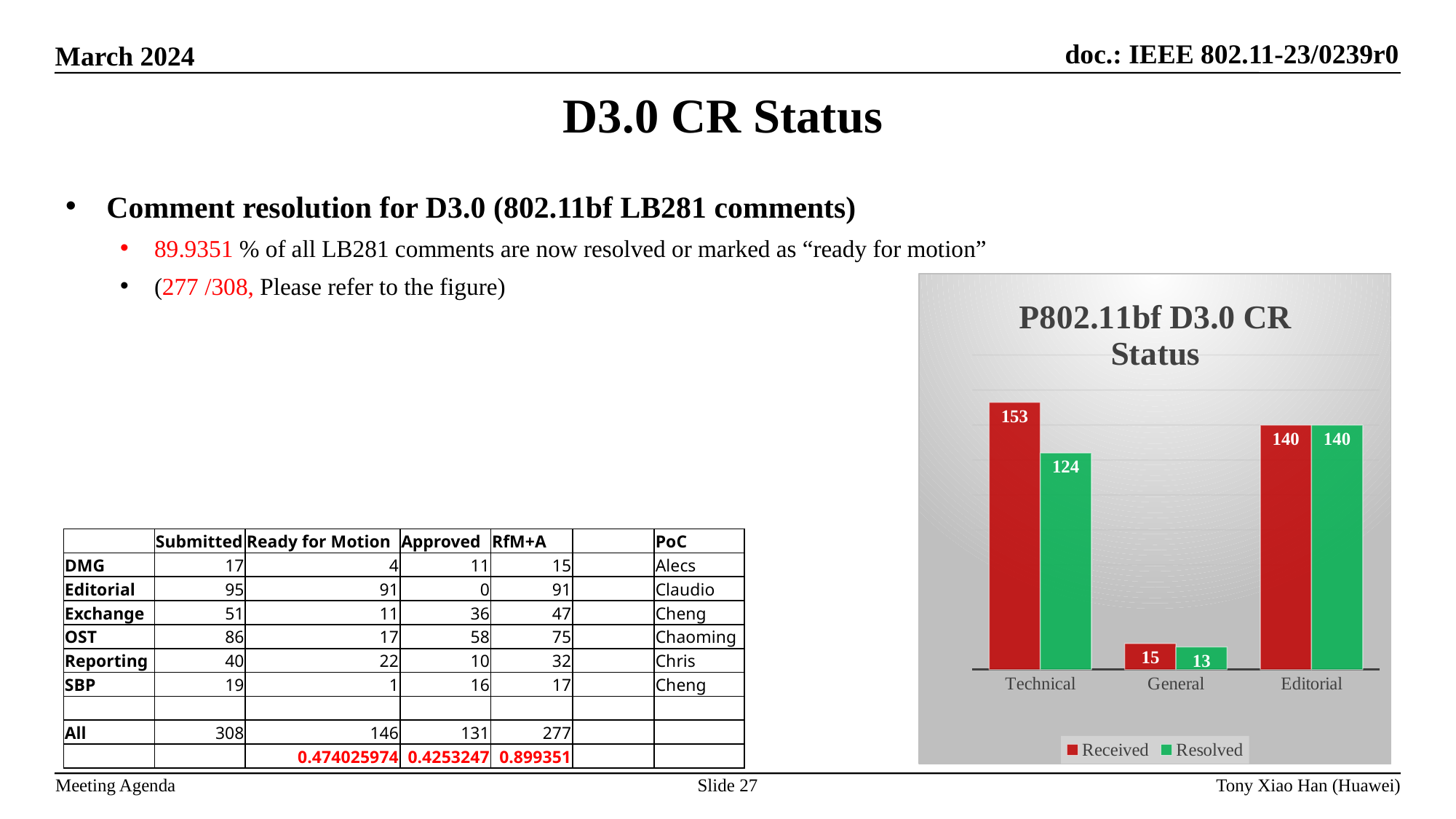
Which category has the lowest Resolved value? General What is the Resolved value for Editorial? 140 What is the difference between Received and Resolved for Technical? 29 What is the Resolved value for Technical? 124 Which category has the highest Received value? Technical What is the Received value for General? 15 What is the Received value for Technical? 153 What kind of chart is shown? Bar chart What is the title of the chart? P802.11bf D3.0 CR Status How many series does the legend list? 2 How many categories are shown on the x axis? 3 Which is larger for General, Received or Resolved? Received